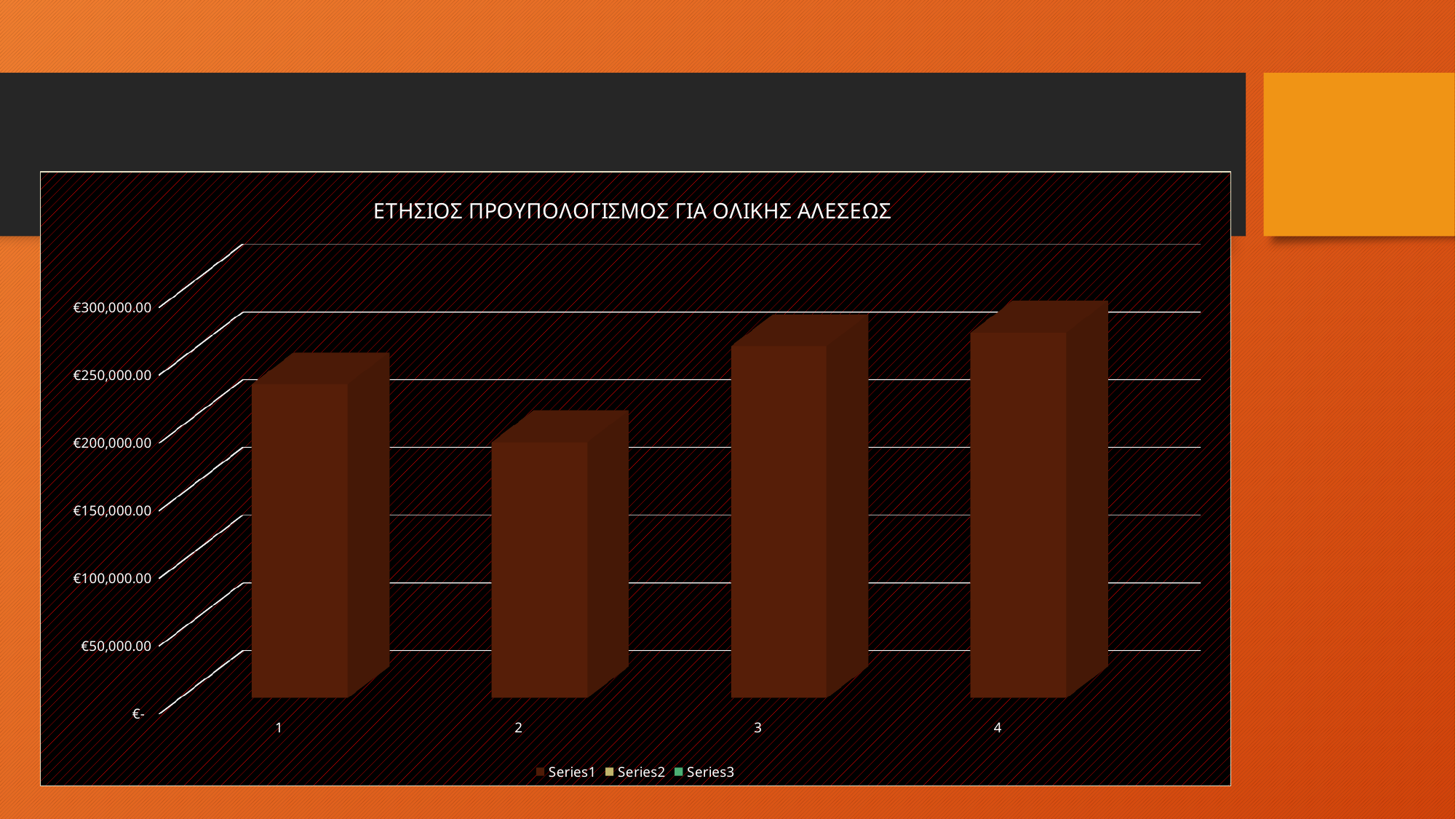
What kind of chart is shown on the slide? Bar chart How many categories are plotted on the x axis? 4 How many series does the legend list? 3 Which category has the lowest bar? 2 Which is larger, the value for category 1 or category 2? Category 1 Is the value for category 4 greater or less than €300,000.00? less Is the value for category 1 greater or less than €200,000.00? greater Is the value for category 2 greater or less than €250,000.00? less Which is larger, the value for category 4 or category 1? Category 4 Which is larger, the value for category 2 or category 3? Category 3 What is the title of the chart? ΕΤΗΣΙΟΣ ΠΡΟΥΠΟΛΟΓΙΣΜΟΣ ΓΙΑ ΟΛΙΚΗΣ ΑΛΕΣΕΩΣ